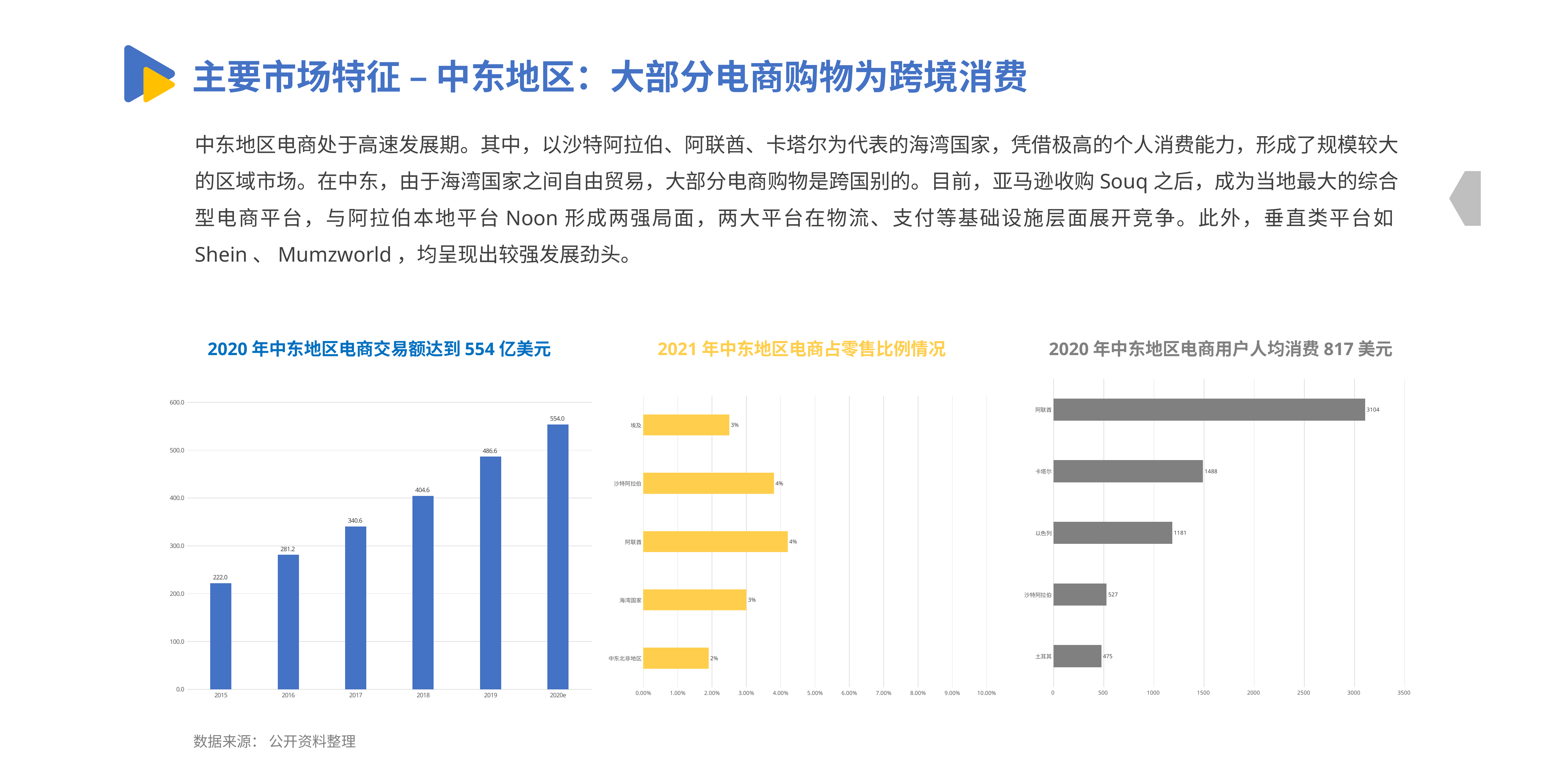
In the right chart (2020年中东地区电商用户人均消费817美元), which is larger, the value for 卡塔尔 or the value for 沙特阿拉伯? 卡塔尔 In the left chart (2020年中东地区电商交易额达到554亿美元), what is the difference between the 2020e value and the 2019 value? 67.4 In the left chart (2020年中东地区电商交易额达到554亿美元), do the values rise or fall from 2015 to 2020e? rise In the middle chart (2021年中东地区电商占零售比例情况), what is the value for 中东北非地区? 2% In the right chart (2020年中东地区电商用户人均消费817美元), which category has the highest value? 阿联酋 In the left chart (2020年中东地区电商交易额达到554亿美元), what is the value for 2018? 404.6 What kind of chart is the left chart (2020年中东地区电商交易额达到554亿美元)? bar chart In the middle chart (2021年中东地区电商占零售比例情况), how many categories are shown? 5 In the left chart (2020年中东地区电商交易额达到554亿美元), what is the value for 2015? 222.0 In the middle chart (2021年中东地区电商占零售比例情况), what colour are the bars? yellow In the right chart (2020年中东地区电商用户人均消费817美元), what is the value for 以色列? 1181 In the left chart (2020年中东地区电商交易额达到554亿美元), how many years are plotted? 6